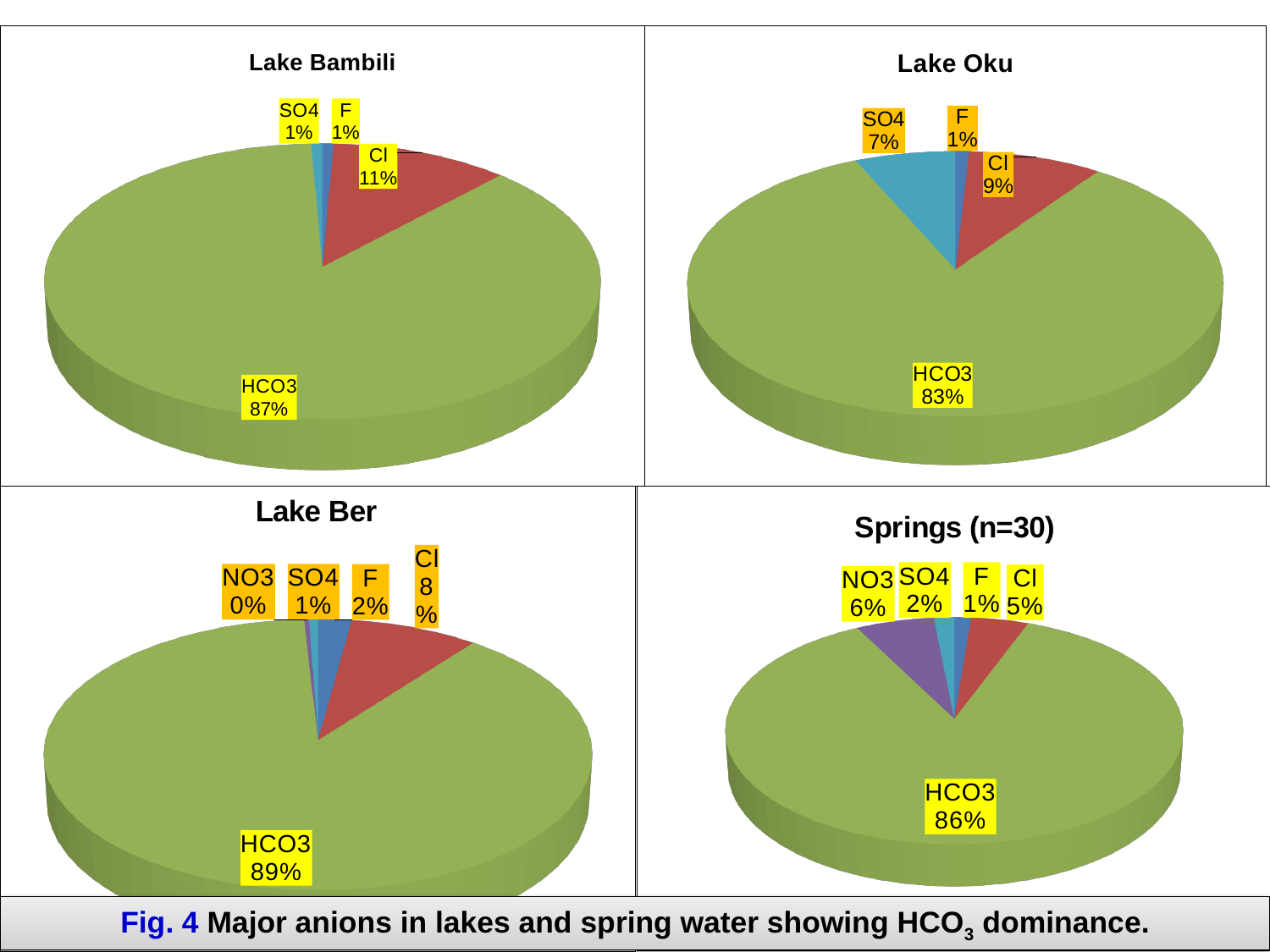
In the Lake Ber chart, which anion has the smallest share? NO3 In the Springs (n=30) chart, what percentage is shown for NO3? 6% In the Lake Oku chart, what percentage is shown for SO4? 7% What kind of chart is the Springs (n=30) chart? Pie chart What is the title of the chart in the top-right position of the slide? Lake Oku In the Springs (n=30) chart, which is larger, the NO3 share or the Cl share? NO3 How many slices are labelled in the Lake Oku chart? 4 How many slices are labelled in the Lake Ber chart? 5 In the Lake Bambili chart, what share of the pie is HCO3? 87% In the Lake Bambili chart, what is the difference between the Cl share and the SO4 share? 10% In the Lake Oku chart, which anion has the largest share? HCO3 In the Lake Ber chart, what percentage is shown for Cl? 8%